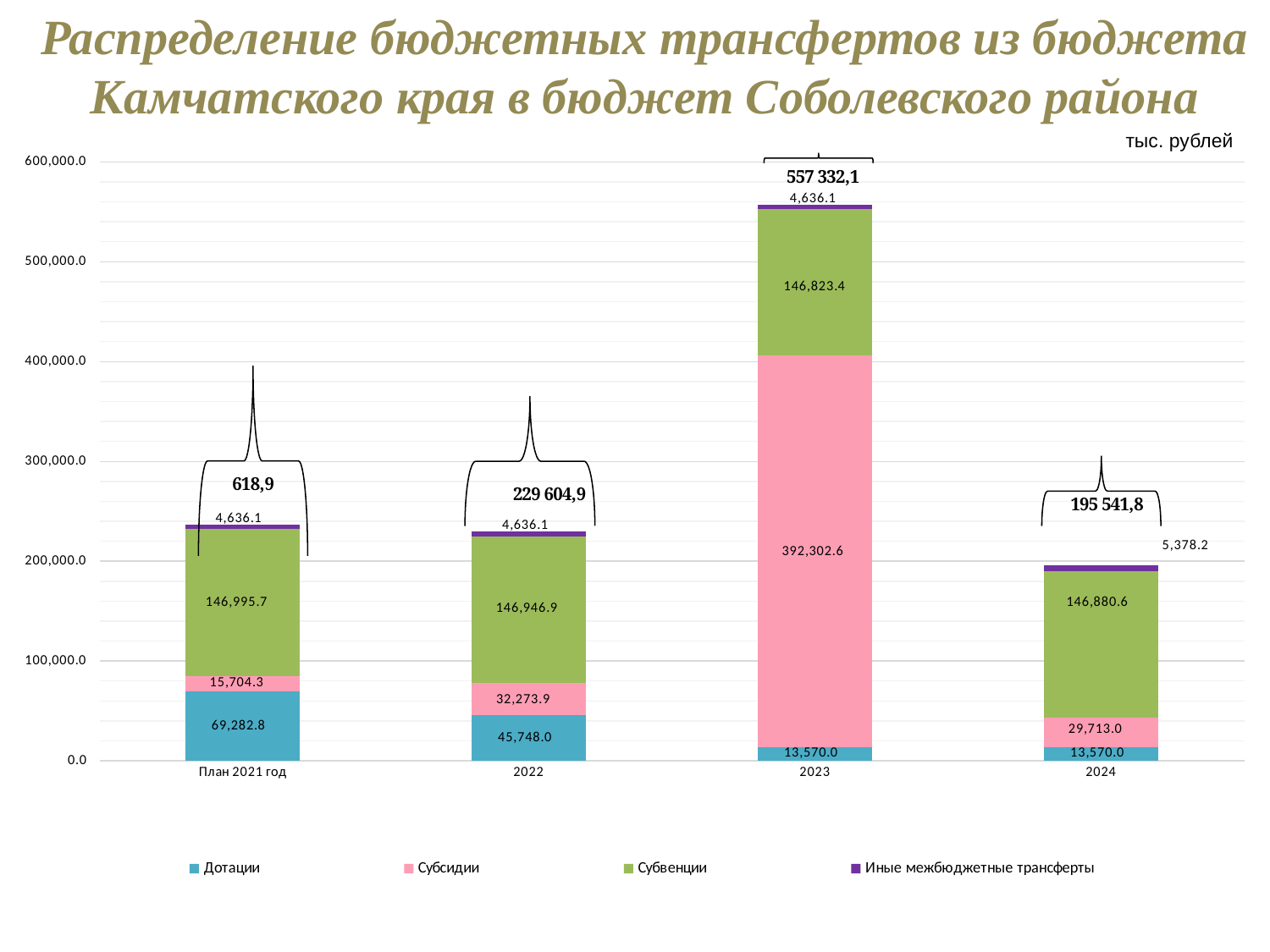
How many series does the legend list? 4 What is the value of Субсидии for 2023? 392,302.6 Which year has the highest total of budget transfers? 2023 What is the value of Иные межбюджетные трансферты for 2024? 5,378.2 What is the total of the stacked bar for 2023? 557 332,1 What kind of chart is shown on the slide? Stacked bar chart What is the difference between the Субсидии values for 2022 and 2024? 2,560.9 What is the value of Дотации for План 2021 год? 69,282.8 Which is larger, Дотации for План 2021 год or Дотации for 2022? План 2021 год How many categories are shown on the x axis? 4 What is the value of Субвенции for 2024? 146,880.6 Which year has the lowest total of budget transfers? 2024